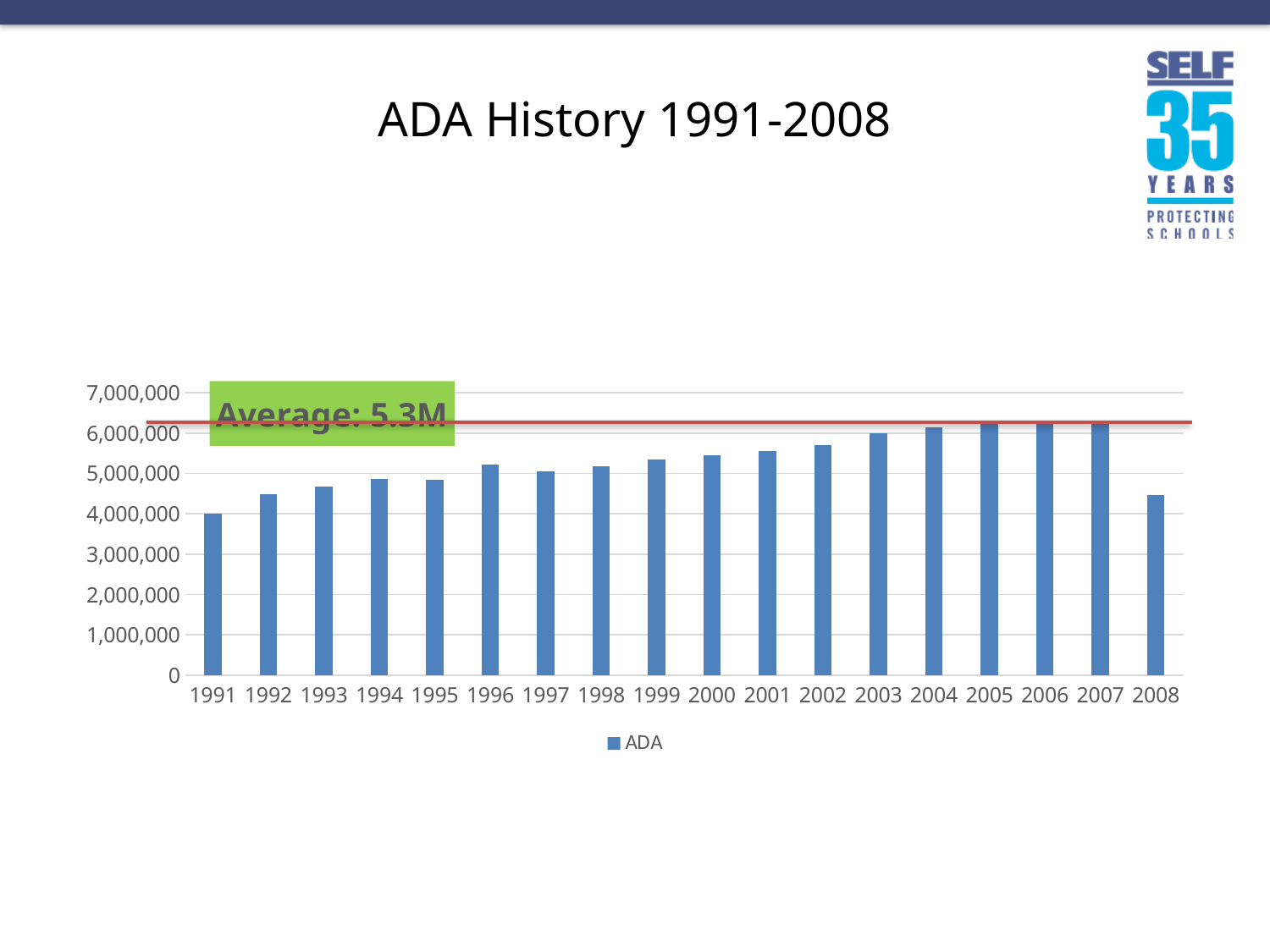
Which year has a larger ADA value, 2007 or 2008? 2007 What kind of chart is shown on the slide? Bar chart Is the ADA value for 2007 greater or less than 6,000,000? greater Which year has a larger ADA value, 1993 or 2003? 2003 Is the ADA value for 2008 greater or less than 5,000,000? less Do the ADA values generally rise or fall from 1991 to 2007? rise What average value is annotated on the chart? Average: 5.3M Is the ADA value for 2002 greater or less than 6,000,000? less Which year has the lowest ADA value in the chart? 1991 How many series does the legend list? 1 How many years (bars) are plotted in the chart? 18